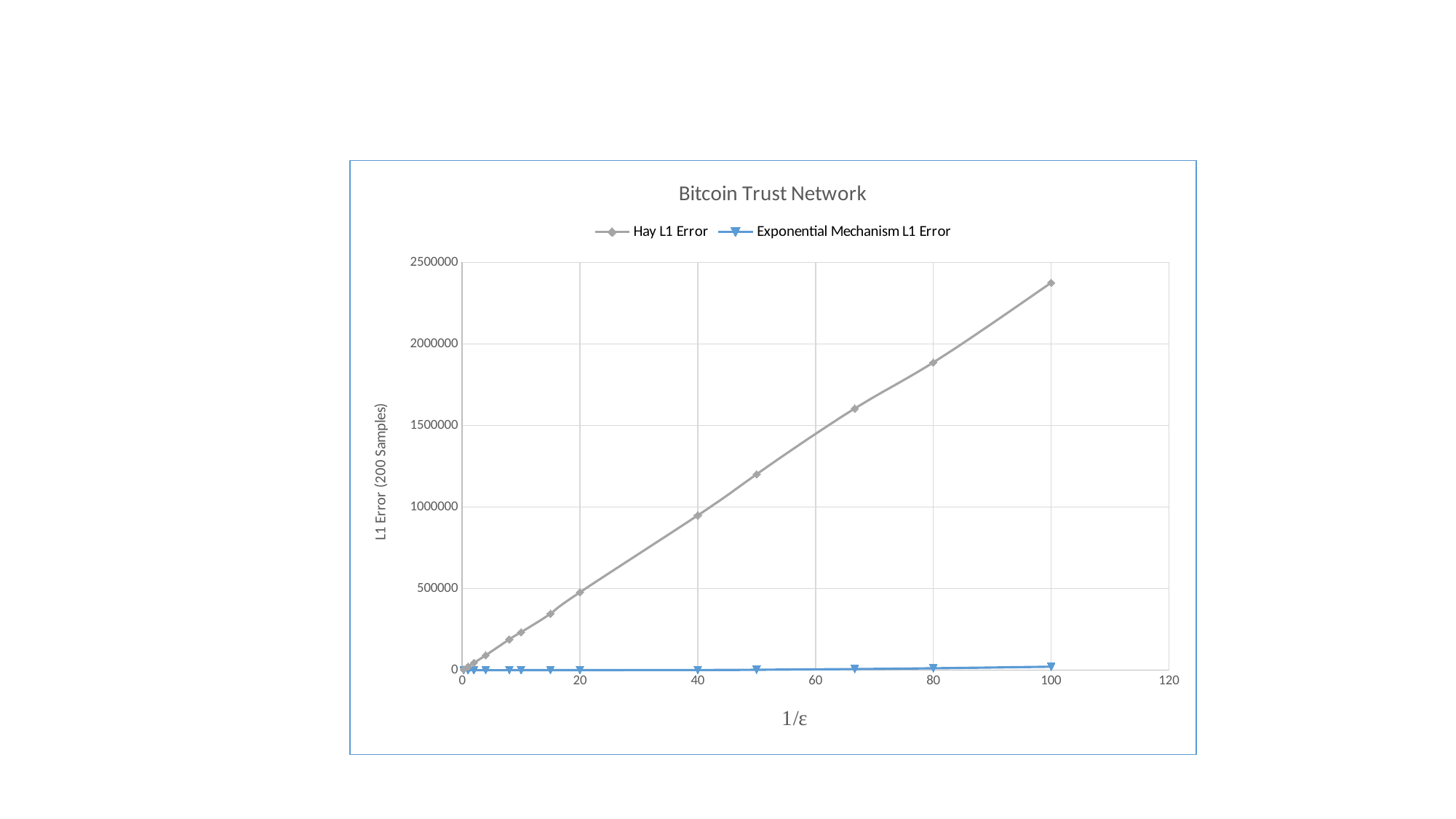
At 1/ε = 100, which series has the larger L1 error, Hay L1 Error or Exponential Mechanism L1 Error? Hay L1 Error Is the Hay L1 Error value at 1/ε = 40 greater or less than 1000000? less Does the Hay L1 Error rise or fall as 1/ε increases? rise What is the title of the chart? Bitcoin Trust Network What label is shown on the x axis? 1/ε Is the Hay L1 Error value at 1/ε = 100 greater or less than 2000000? greater Is the Exponential Mechanism L1 Error value at 1/ε = 100 greater or less than 500000? less Which series reaches the highest L1 error on the chart? Hay L1 Error What kind of chart is shown on the slide? line chart How many series does the legend list? 2